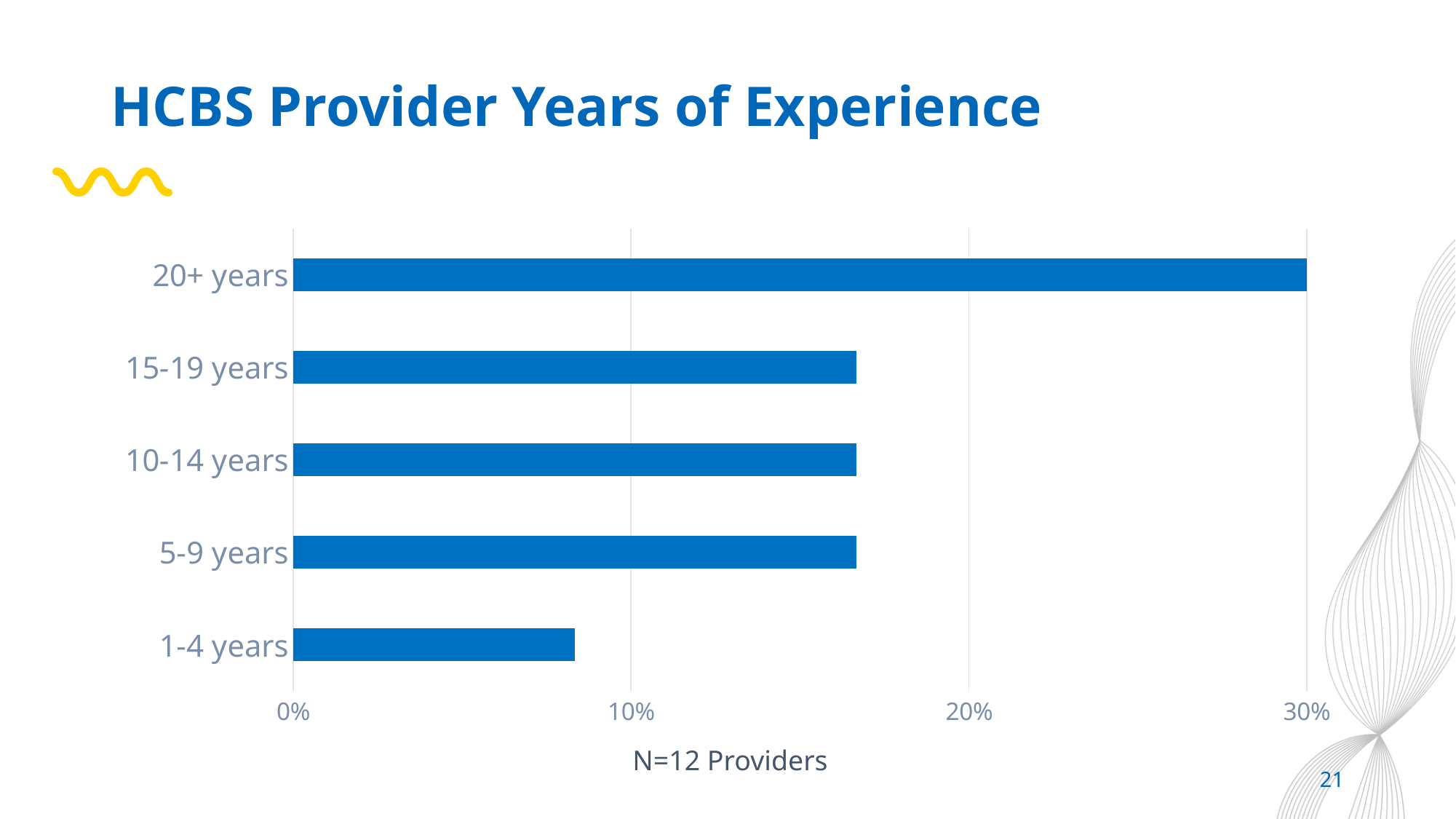
Which is larger, the value for 20+ years or the value for 1-4 years? 20+ years How many providers does the note below the chart say were included? N=12 Providers Which experience category has the lowest value? 1-4 years Which is larger, the value for 15-19 years or the value for 1-4 years? 15-19 years Is the value for 5-9 years greater or less than 20%? less What is the title of the slide's chart? HCBS Provider Years of Experience Which experience category has the highest value? 20+ years What kind of chart is shown on the slide? bar chart Is the value for 20+ years greater or less than 20%? greater Is the value for 15-19 years greater or less than 10%? greater How many experience categories are shown in the chart? 5